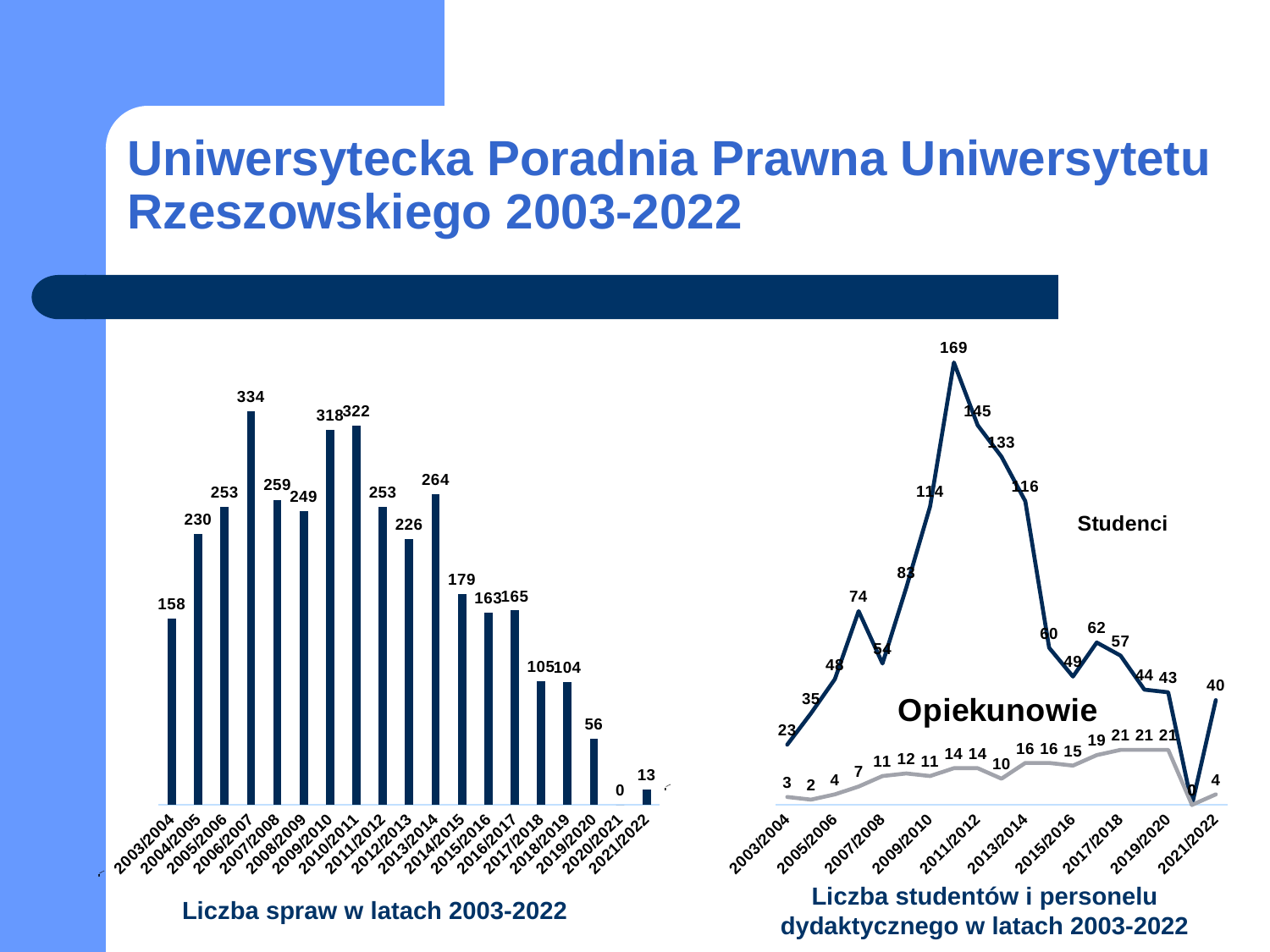
In the chart 'Liczba spraw w latach 2003-2022', which is larger, the value for 2014/2015 or the value for 2019/2020? 2014/2015 In the chart 'Liczba studentów i personelu dydaktycznego w latach 2003-2022', how many series are plotted? 2 In the chart 'Liczba spraw w latach 2003-2022', what is the value for 2007/2008? 259 In the chart 'Liczba spraw w latach 2003-2022', how many years are shown on the x axis? 19 In the chart 'Liczba studentów i personelu dydaktycznego w latach 2003-2022', what is the Opiekunowie value for 2021/2022? 4 What kind of chart is 'Liczba studentów i personelu dydaktycznego w latach 2003-2022'? line chart In the chart 'Liczba studentów i personelu dydaktycznego w latach 2003-2022', what is the difference between the Studenci and Opiekunowie values for 2021/2022? 36 In the chart 'Liczba spraw w latach 2003-2022', which year has the highest value? 2006/2007 In the chart 'Liczba studentów i personelu dydaktycznego w latach 2003-2022', what is the Studenci value for 2010/2011? 169 What kind of chart is 'Liczba spraw w latach 2003-2022'? bar chart In the chart 'Liczba spraw w latach 2003-2022', what is the difference between the values for 2006/2007 and 2003/2004? 176 In the chart 'Liczba spraw w latach 2003-2022', which year has the lowest value? 2020/2021